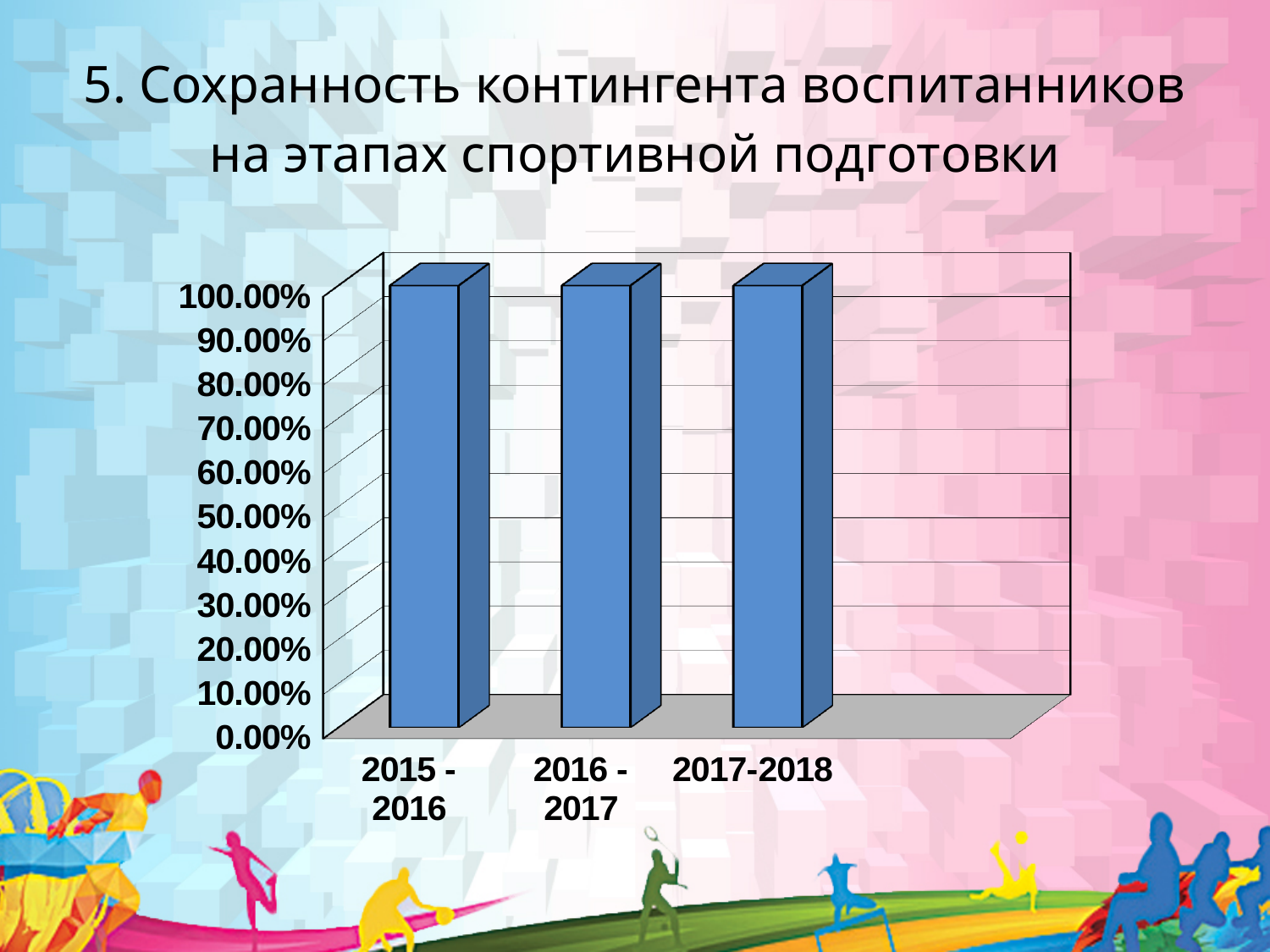
Is the value for 2017-2018 greater or less than 50.00%? greater What kind of chart is shown on the slide? bar chart Is the value for 2015 - 2016 greater or less than 70.00%? greater Is the value for 2015 - 2016 greater or less than 90.00%? greater Do the values rise, fall, or stay about the same across the periods from 2015 - 2016 to 2017-2018? stay about the same How many categories (periods) are shown on the x axis of the chart? 3 What is the label of the last category on the x axis? 2017-2018 What is the highest value shown on the vertical axis of the chart? 100.00% What is the label of the first category on the x axis? 2015 - 2016